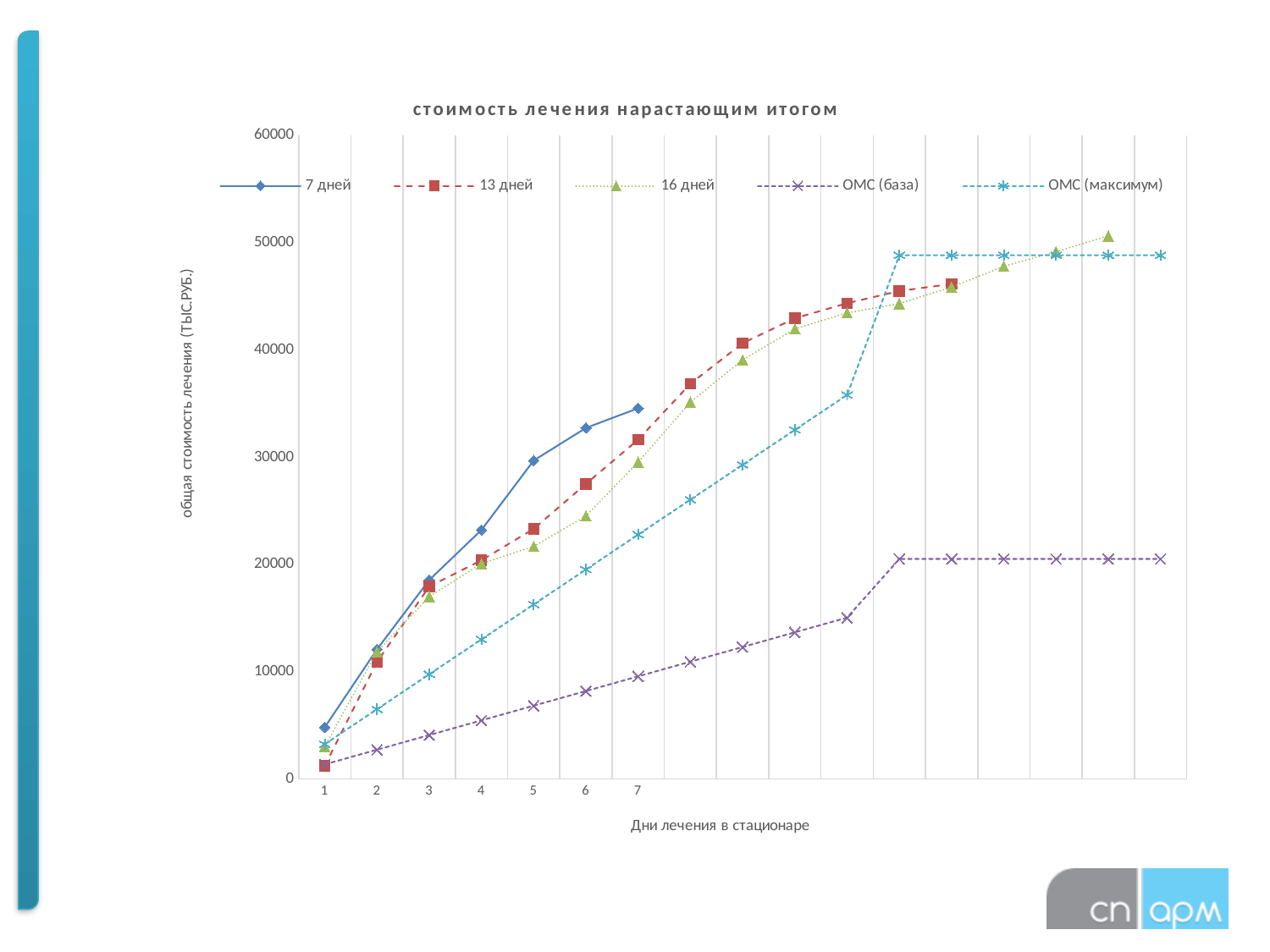
On day 7, which series has the lowest value? ОМС (база) On day 7, which series has the highest value? 7 дней Is the value for the ОМС (максимум) series on day 7 greater or less than 20000? greater What kind of chart is shown on the slide? line chart On day 5, which series has the larger value: 7 дней or 13 дней? 7 дней Is the value for the 7 дней series on day 7 greater or less than 30000? greater Does the 7 дней series rise or fall from day 1 to day 7? rise What is the label of the x axis? Дни лечения в стационаре Is the value for the 16 дней series on day 3 greater or less than 20000? less How many series does the legend list? 5 What is the title of the chart? стоимость лечения нарастающим итогом